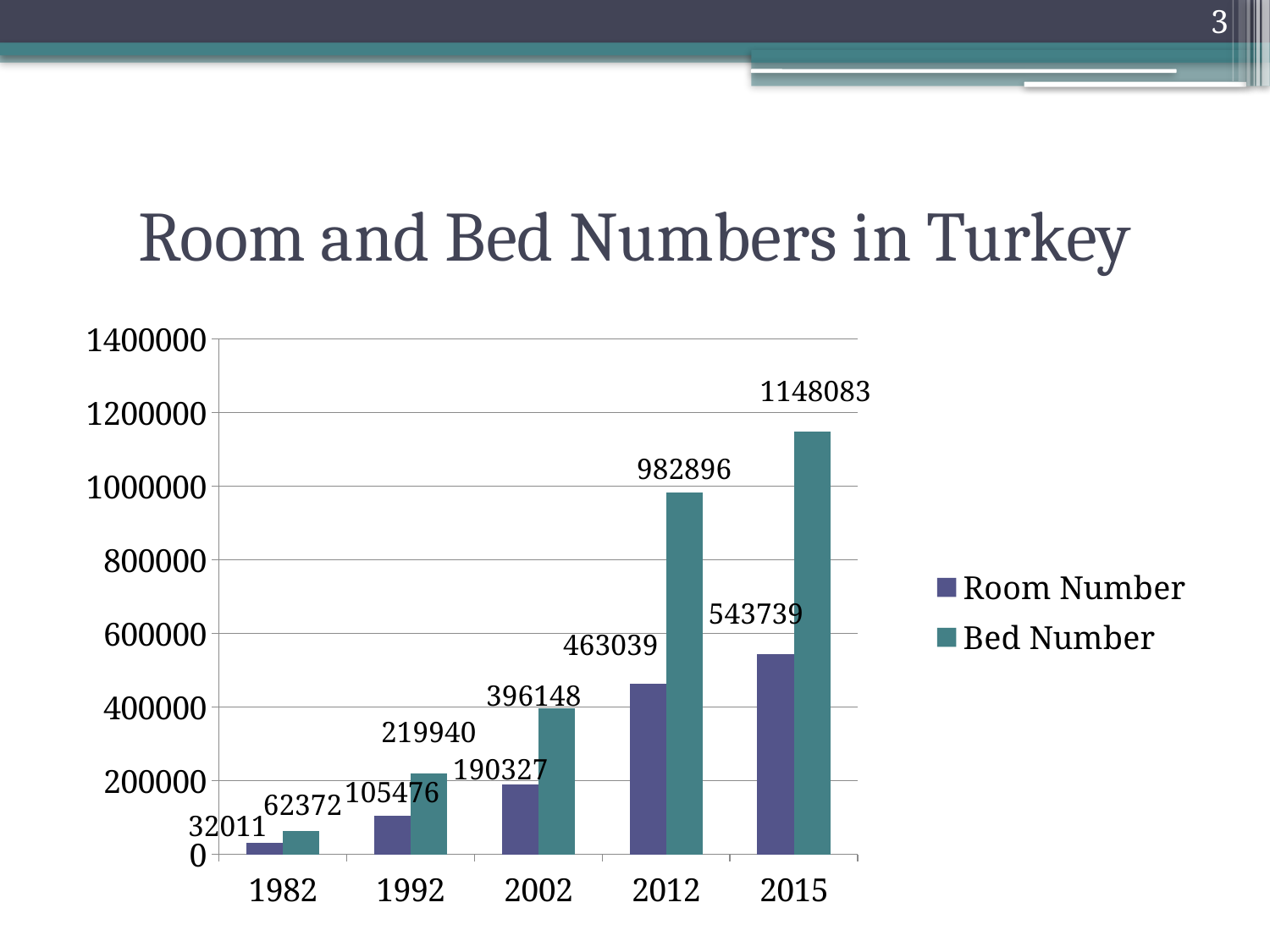
Which year has the lowest Room Number? 1982 What is the Room Number for 2002? 190327 What is the difference between the Bed Number and the Room Number in 2015? 604344 What is the Room Number for 2012? 463039 Does the Room Number rise or fall from 1982 to 2015? Rise What is the Bed Number for 1982? 62372 How many years are shown on the x axis? 5 What is the Bed Number for 2015? 1148083 Which year has the highest Bed Number? 2015 How many series does the legend list? 2 What kind of chart is shown on the slide? Bar chart Which is larger, the Room Number in 2012 or the Bed Number in 2002? Room Number in 2012